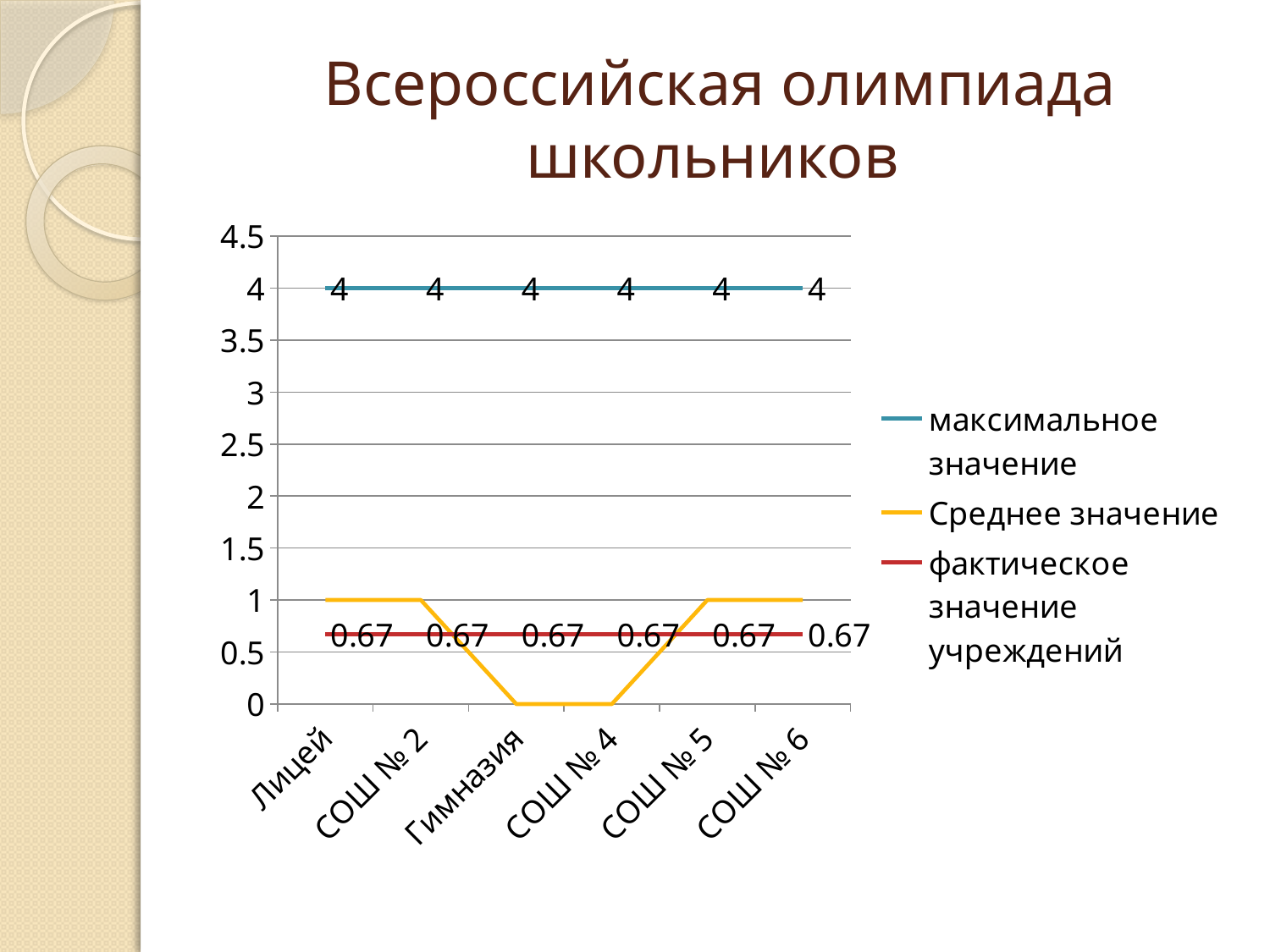
How many categories are shown on the x axis? 6 What is the value of "фактическое значение учреждений" for Гимназия? 0.67 What type of chart is shown on the slide? line chart What is the title of the slide? Всероссийская олимпиада школьников How many series does the legend list? 3 What is the value of "максимальное значение" for СОШ № 4? 4 What is the difference between "максимальное значение" and "фактическое значение учреждений" for СОШ № 6? 3.33 Is the value of "фактическое значение учреждений" for Лицей greater or less than 1? less What is the value of "Среднее значение" for Лицей? 1 What is the value of "Среднее значение" for Гимназия? 0 Which series is drawn in blue? максимальное значение Which is larger for СОШ № 2: "Среднее значение" or "фактическое значение учреждений"? Среднее значение